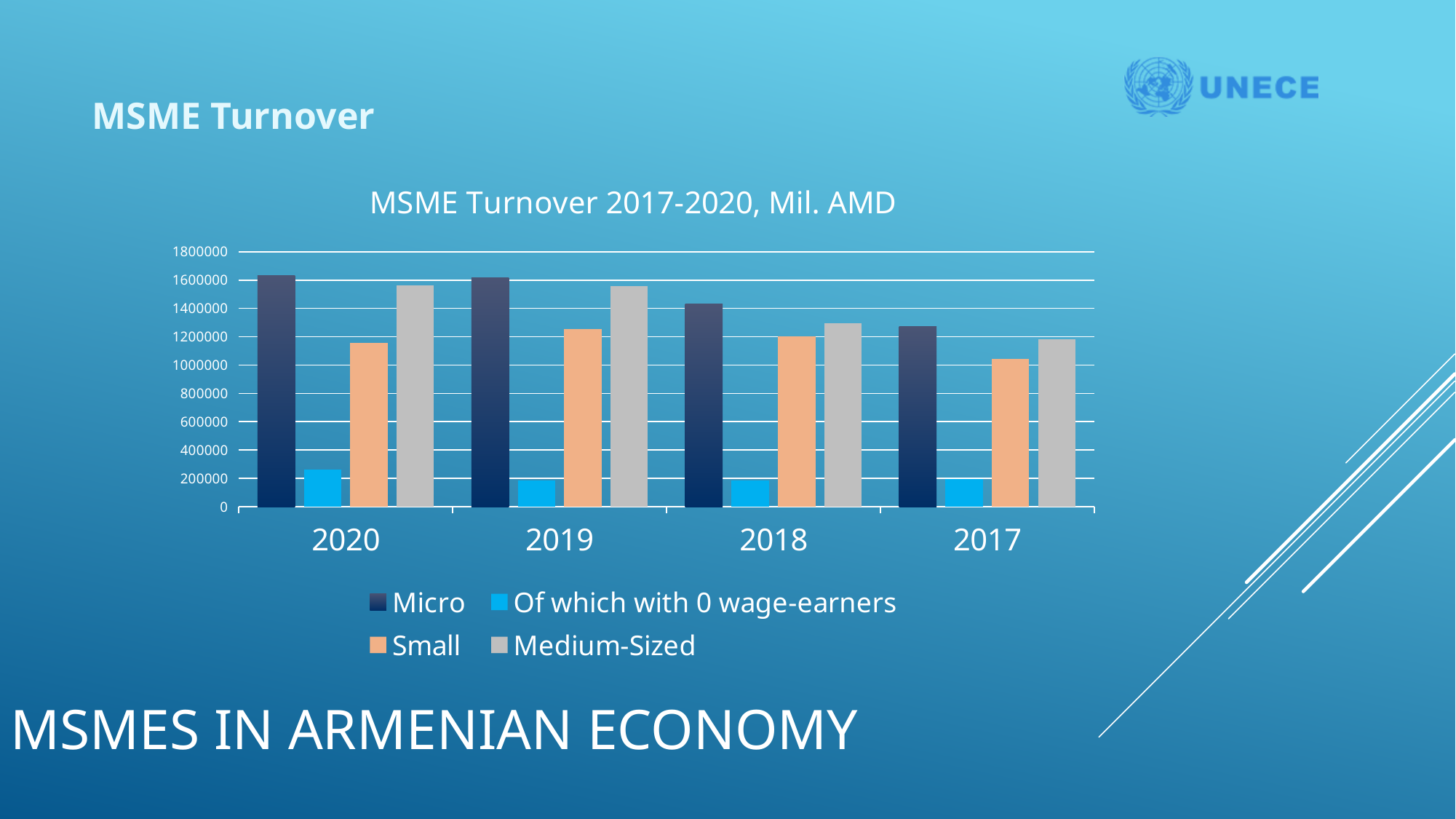
Is the value for Small in 2020 greater or less than 1200000? less In which year is the Micro series lowest? 2017 What is the title of the chart? MSME Turnover 2017-2020, Mil. AMD Is the value for 'Of which with 0 wage-earners' in 2020 greater or less than 200000? greater How many series does the legend list? 4 Is the value for Micro in 2017 greater or less than 1200000? greater Reading left to right along the x axis (2020 to 2017), do the Micro bars rise or fall? fall In 2018, which is larger: Micro or Medium-Sized? Micro What kind of chart is shown on the slide? bar chart In which year is the 'Of which with 0 wage-earners' series highest? 2020 How many years are shown on the x axis? 4